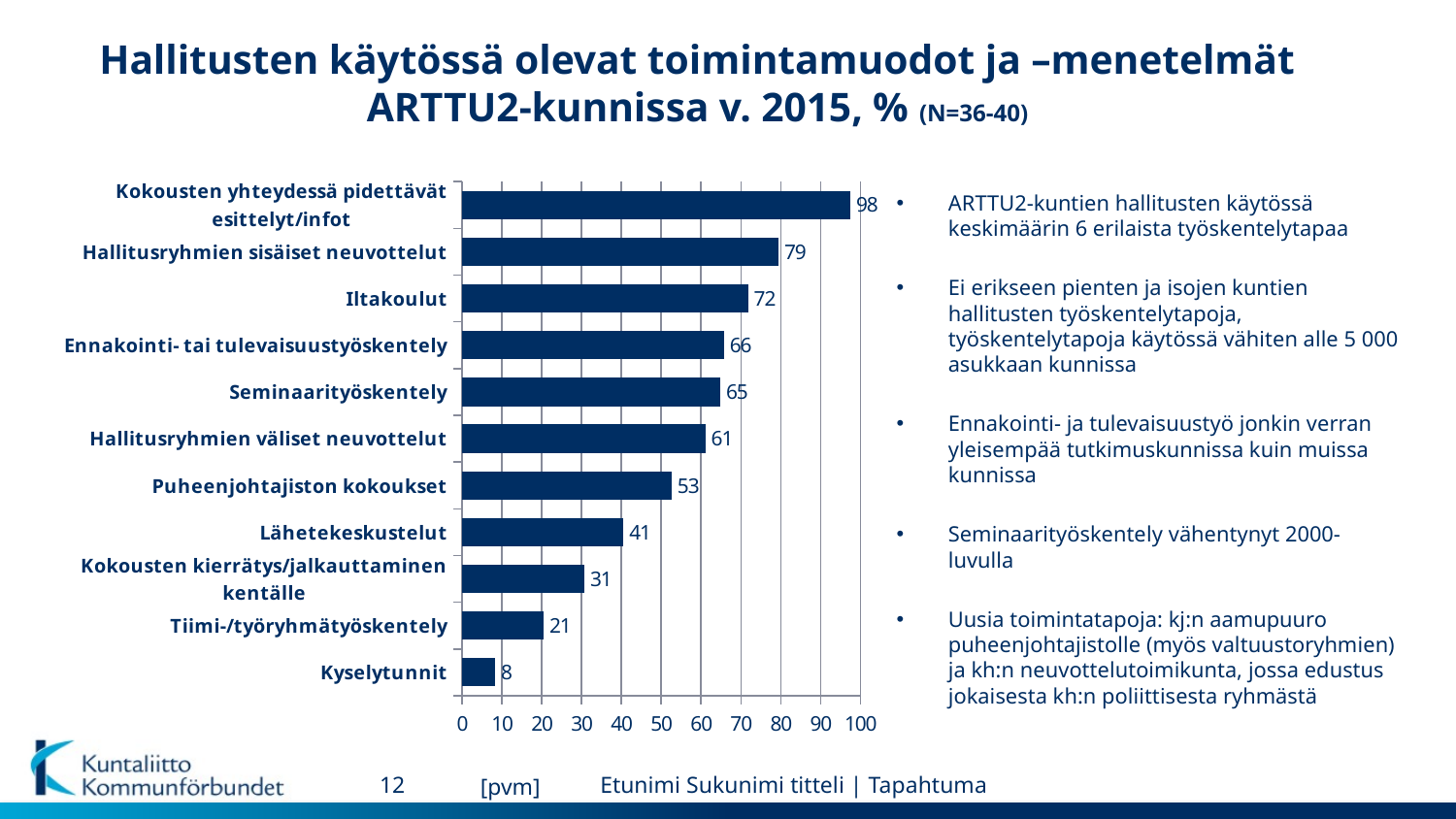
What is the difference between the values for Puheenjohtajiston kokoukset and Lähetekeskustelut? 12 What is the value for Kyselytunnit? 8 What kind of chart is shown on the slide? bar chart What is the value for Hallitusryhmien sisäiset neuvottelut? 79 Is the value for Tiimi-/työryhmätyöskentely greater or less than 30? less How many categories are shown in the chart? 11 Which is larger, the value for Seminaarityöskentely or the value for Hallitusryhmien väliset neuvottelut? Seminaarityöskentely What is the value for Ennakointi- tai tulevaisuustyöskentely? 66 Which category has the highest value? Kokousten yhteydessä pidettävät esittelyt/infot What is the maximum value shown on the horizontal axis of the chart? 100 What is the value for Iltakoulut? 72 Which category has the lowest value? Kyselytunnit